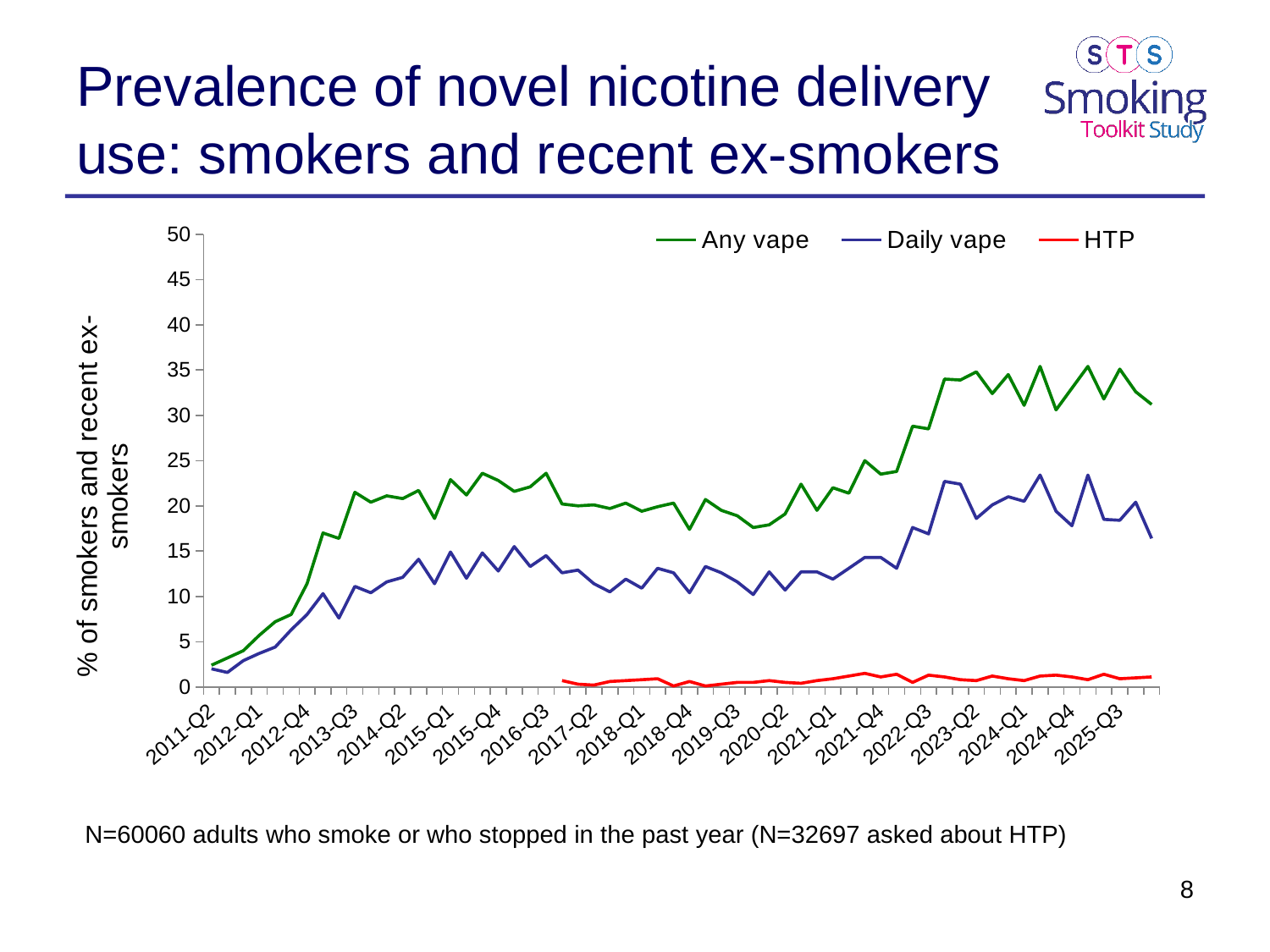
Which series has the lowest values across the whole period shown? HTP Is the value for HTP at 2025-Q3 greater or less than 5? less What colour is the HTP line? Red At 2025-Q3, which is larger: Any vape or Daily vape? Any vape Is the value for Any vape at 2023-Q2 greater or less than 30? greater What kind of chart is shown on the slide? Line chart Is the value for Any vape at 2011-Q2 greater or less than 5? less Does the Any vape line rise or fall between 2011-Q2 and 2013-Q3? Rise How many series does the legend list? 3 What are the three series named in the legend? Any vape, Daily vape, HTP